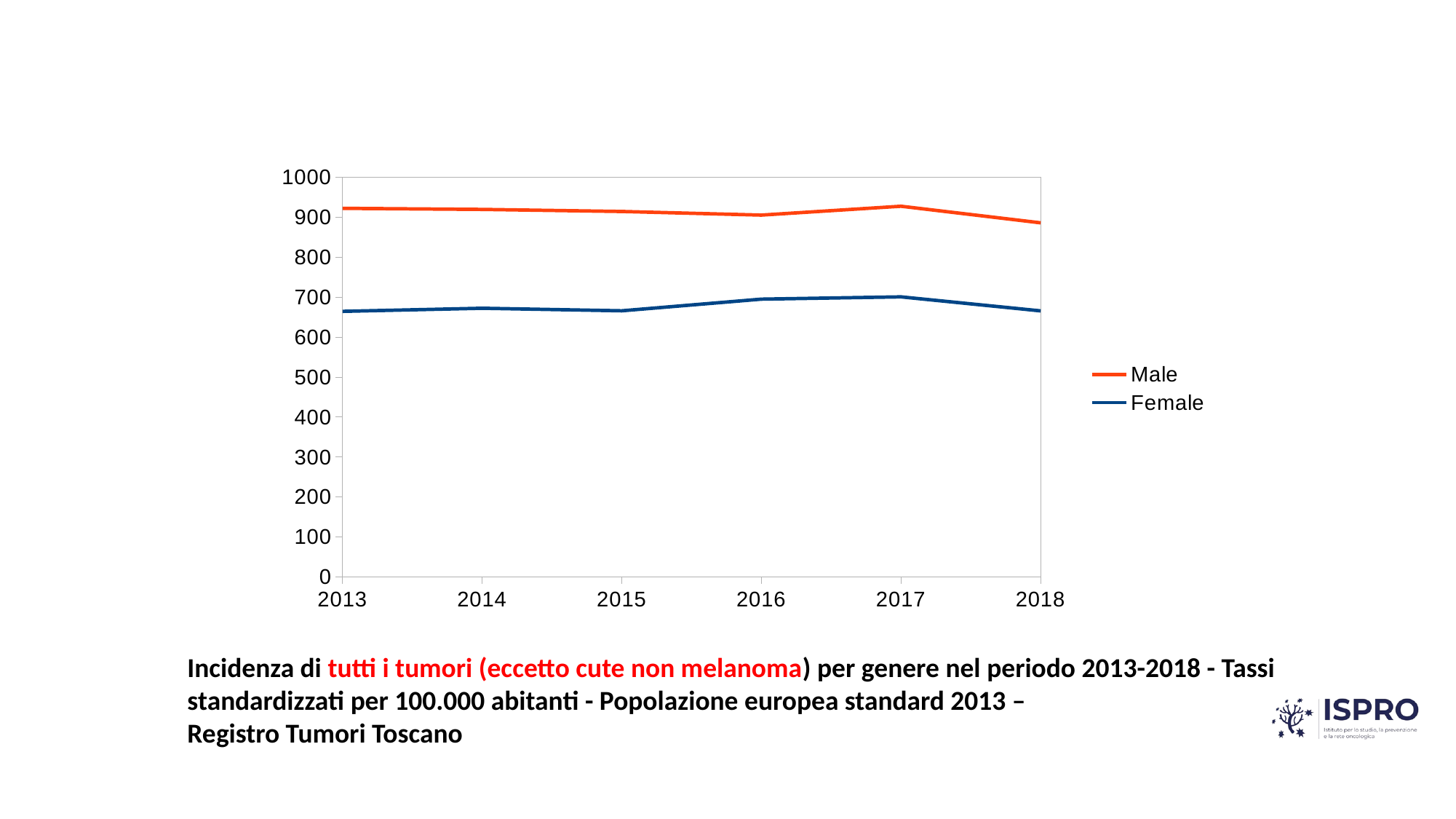
Does the Male series rise or fall from 2017 to 2018? fall Which colour is used for the Female series? dark blue In which year is the Male series at its highest? 2017 What kind of chart is shown on the slide? line chart Is the value for Female in 2015 greater or less than 600? greater How many years are plotted along the x axis? 6 Is the value for Male in 2013 greater or less than 900? greater Is the value for Male in 2018 greater or less than 900? less Which series has the higher value in 2015, Male or Female? Male How many series does the legend list? 2 In which year is the Male series at its lowest? 2018